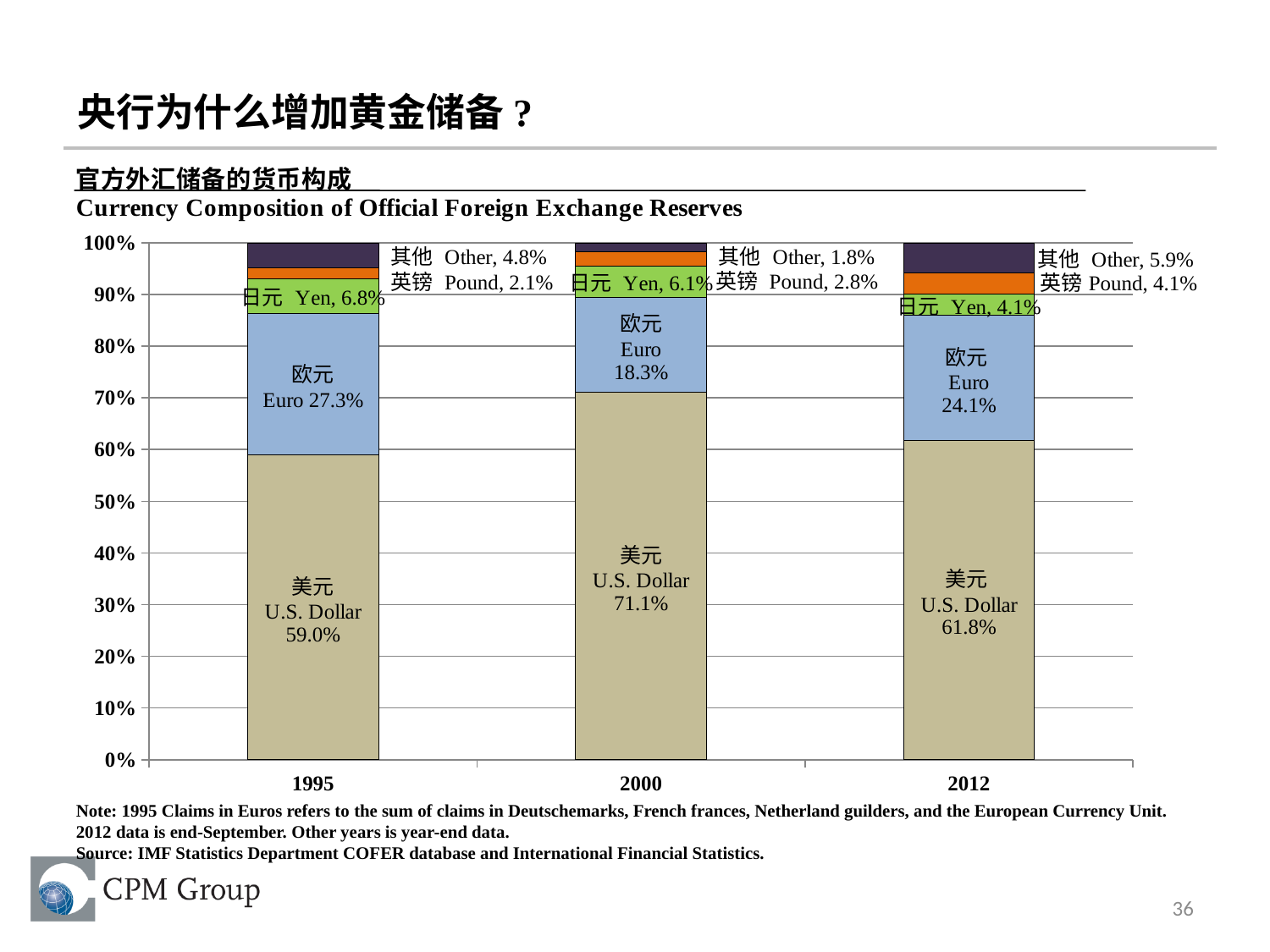
How many years are shown on the x axis of the chart? 3 How many currency categories make up each stacked bar? 5 Did the Yen's share of reserves rise or fall from 1995 to 2012? Fall What was the Yen's share of reserves in 2012? 4.1% What type of chart is shown on the slide? Stacked bar chart By how many percentage points did the U.S. Dollar's share change from 1995 to 2000? 12.1 percentage points Which was larger in 2012, the Euro's share or the U.S. Dollar's share? U.S. Dollar What was the Pound's share of reserves in 2000? 2.8% What was the Euro's share of official foreign exchange reserves in 1995? 27.3% What share of official foreign exchange reserves was held in U.S. Dollars in 2000? 71.1% In which year was the 'Other' category's share of reserves lowest? 2000 In which year was the U.S. Dollar's share of reserves highest? 2000